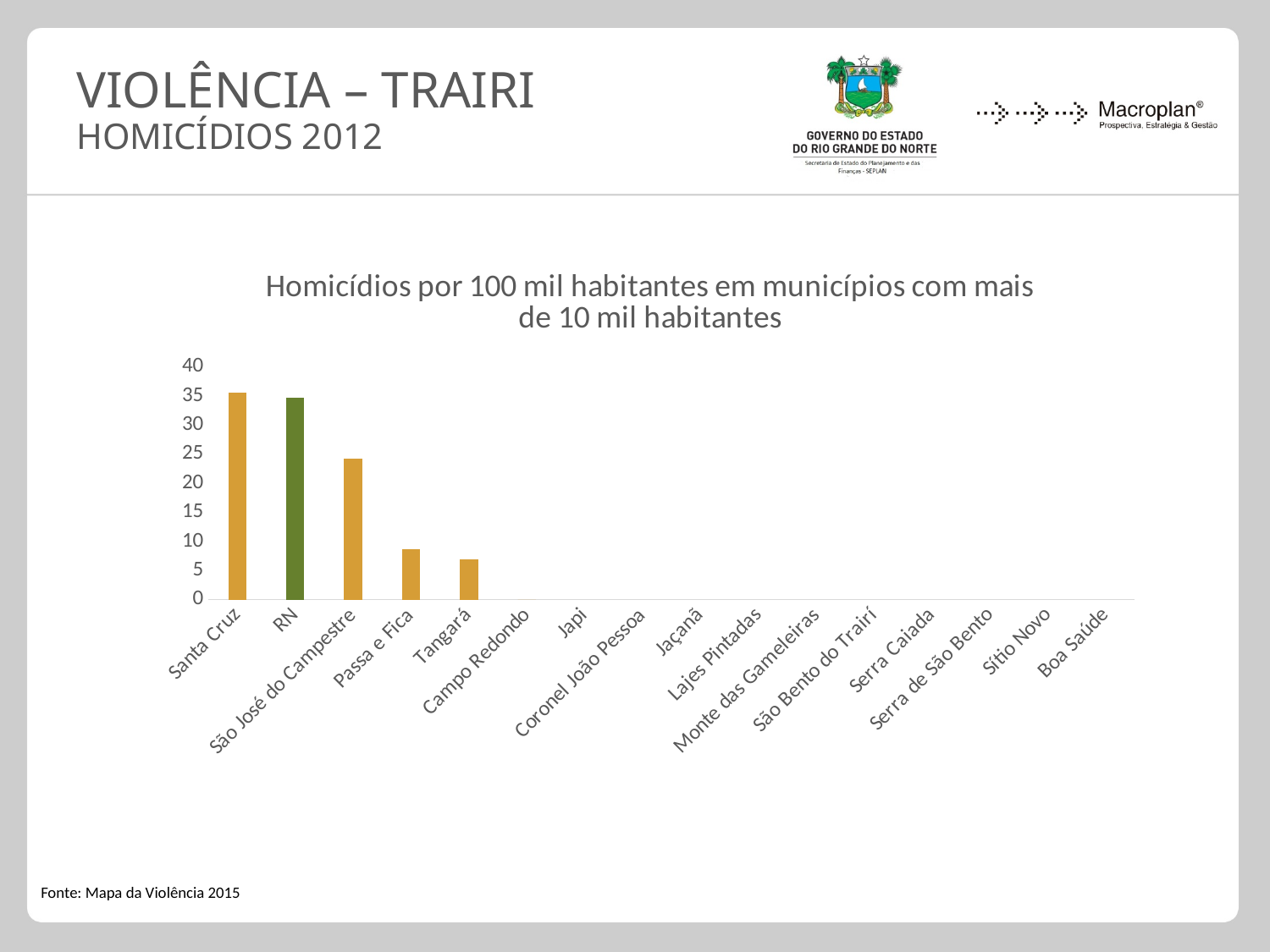
How many categories are shown on the x axis of the chart? 16 Is the value for Passa e Fica greater or less than 10? less Is the value for São José do Campestre greater or less than 25? less Which category's bar is coloured green rather than orange? RN Do the bar values rise or fall from left to right along the x axis? fall Which has a higher value, Passa e Fica or Tangará? Passa e Fica Which has a higher value, São José do Campestre or Passa e Fica? São José do Campestre Is the value for Tangará greater or less than 5? greater What kind of chart is shown on the slide? bar chart